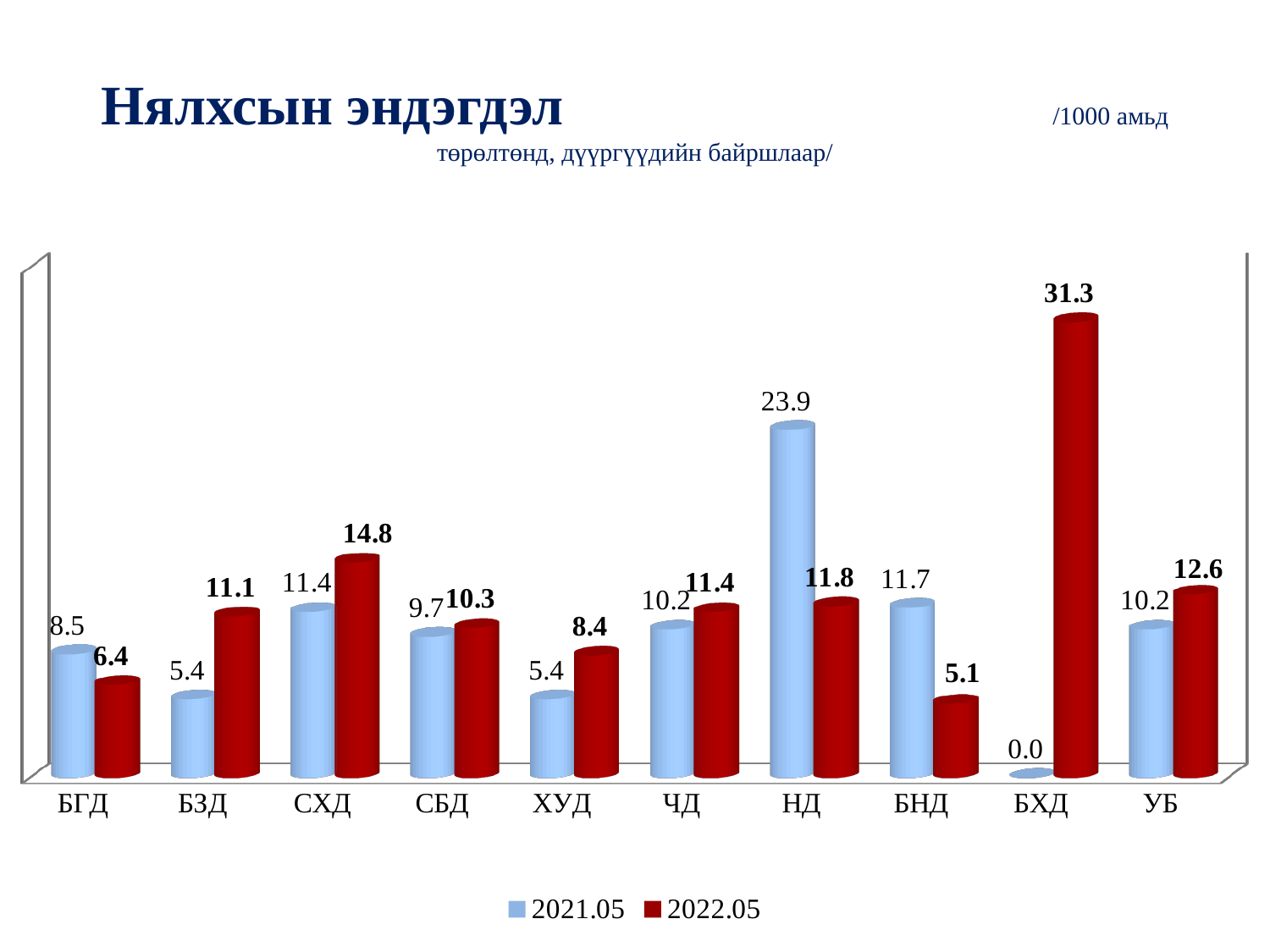
How many series does the legend list? 2 Which district has the lowest 2021.05 value? БХД Which district has the highest 2022.05 value? БХД What kind of chart is shown on the slide? Bar chart Which series is shown in dark red? 2022.05 What is the 2021.05 value for НД? 23.9 What is the 2022.05 value for СХД? 14.8 What is the 2022.05 value for БХД? 31.3 What is the 2021.05 value for БХД? 0.0 For БНД, which is larger: the 2021.05 value or the 2022.05 value? 2021.05 What is the difference between the 2022.05 and 2021.05 values for БЗД? 5.7 How many districts (categories) are shown on the x axis? 10